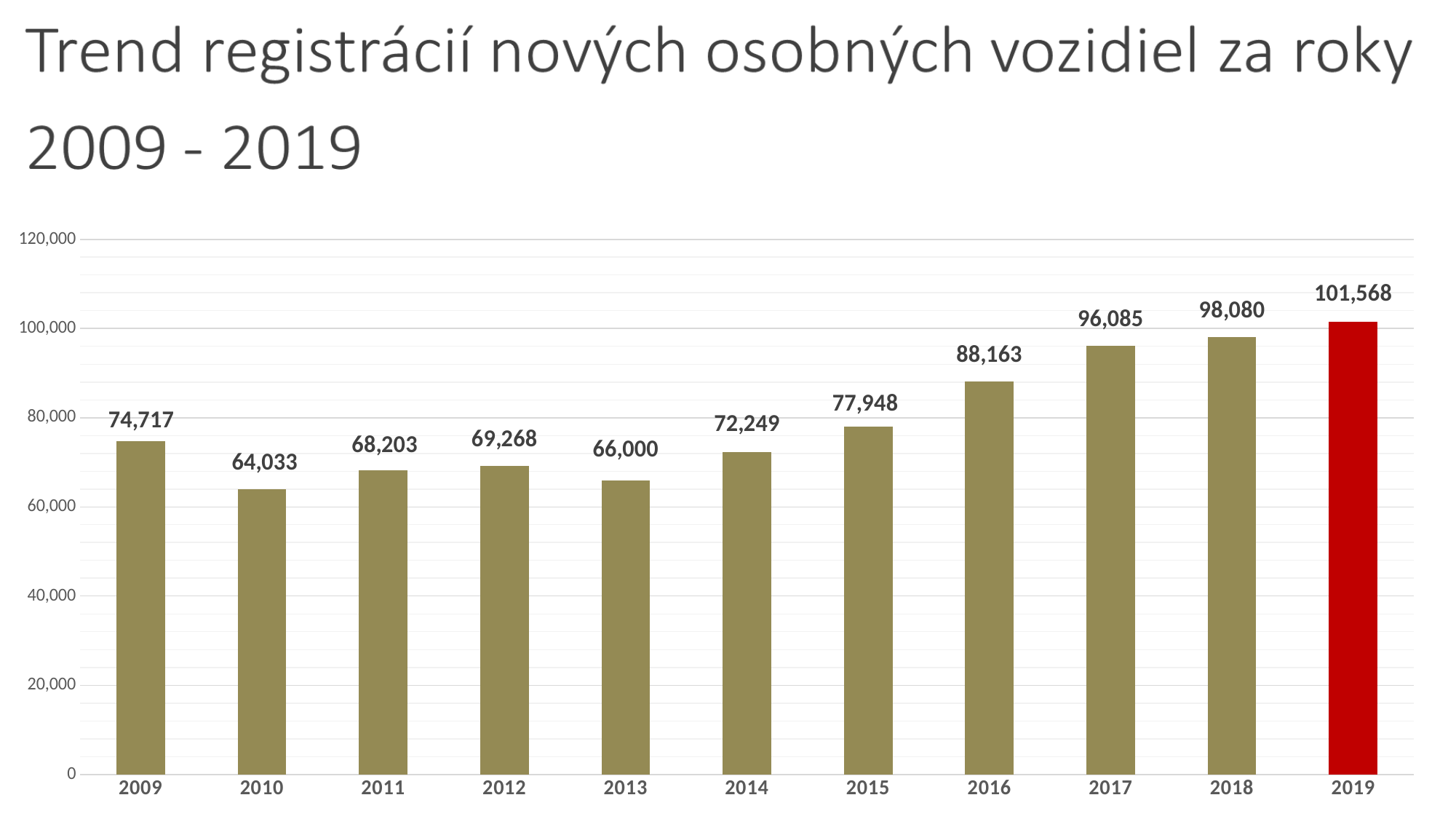
What is the value for 2016? 88,163 Which bar is coloured red rather than olive? 2019 What is the value for 2019? 101,568 What kind of chart is shown on the slide? bar chart Which year has the lowest value? 2010 Which is larger, the value for 2012 or the value for 2013? 2012 How many years are shown on the x axis? 11 What is the value for 2009? 74,717 Which year has the highest value? 2019 Is the value for 2017 greater or less than 100,000? less What is the difference between the values for 2019 and 2018? 3,488 What is the difference between the values for 2009 and 2010? 10,684